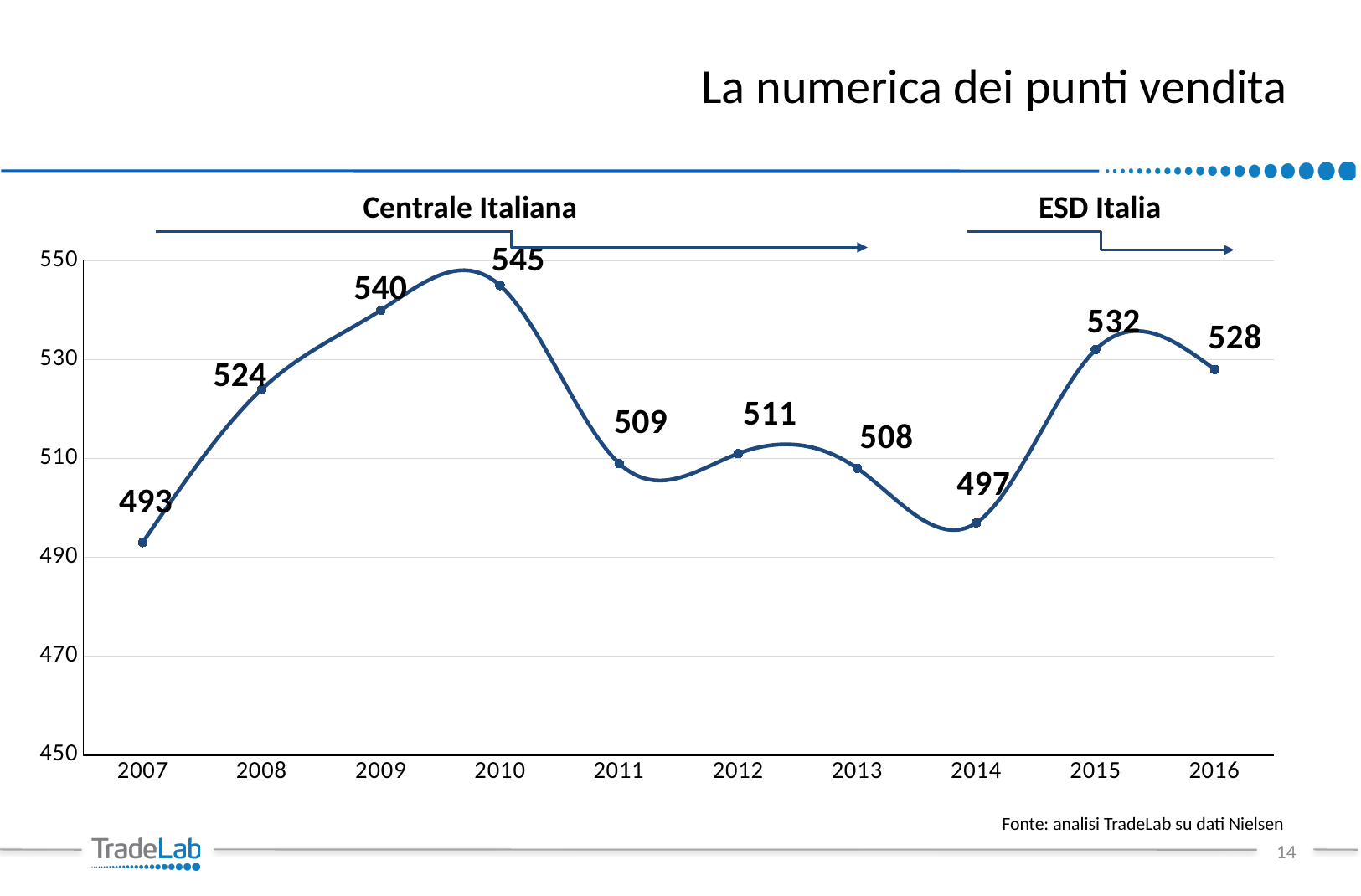
How many years are plotted on the x axis? 10 What is the difference between the values for 2016 and 2015? 4 Which period label is shown above the years 2007 to 2013? Centrale Italiana What kind of chart is shown on the slide? line chart What is the difference between the values for 2010 and 2014? 48 What is the value for 2007? 493 Which year has the lowest value? 2007 Which is larger, the value for 2012 or the value for 2013? 2012 Is the value for 2009 greater or less than 530? greater Which year has the highest value? 2010 What is the value for 2010? 545 What is the value for 2014? 497